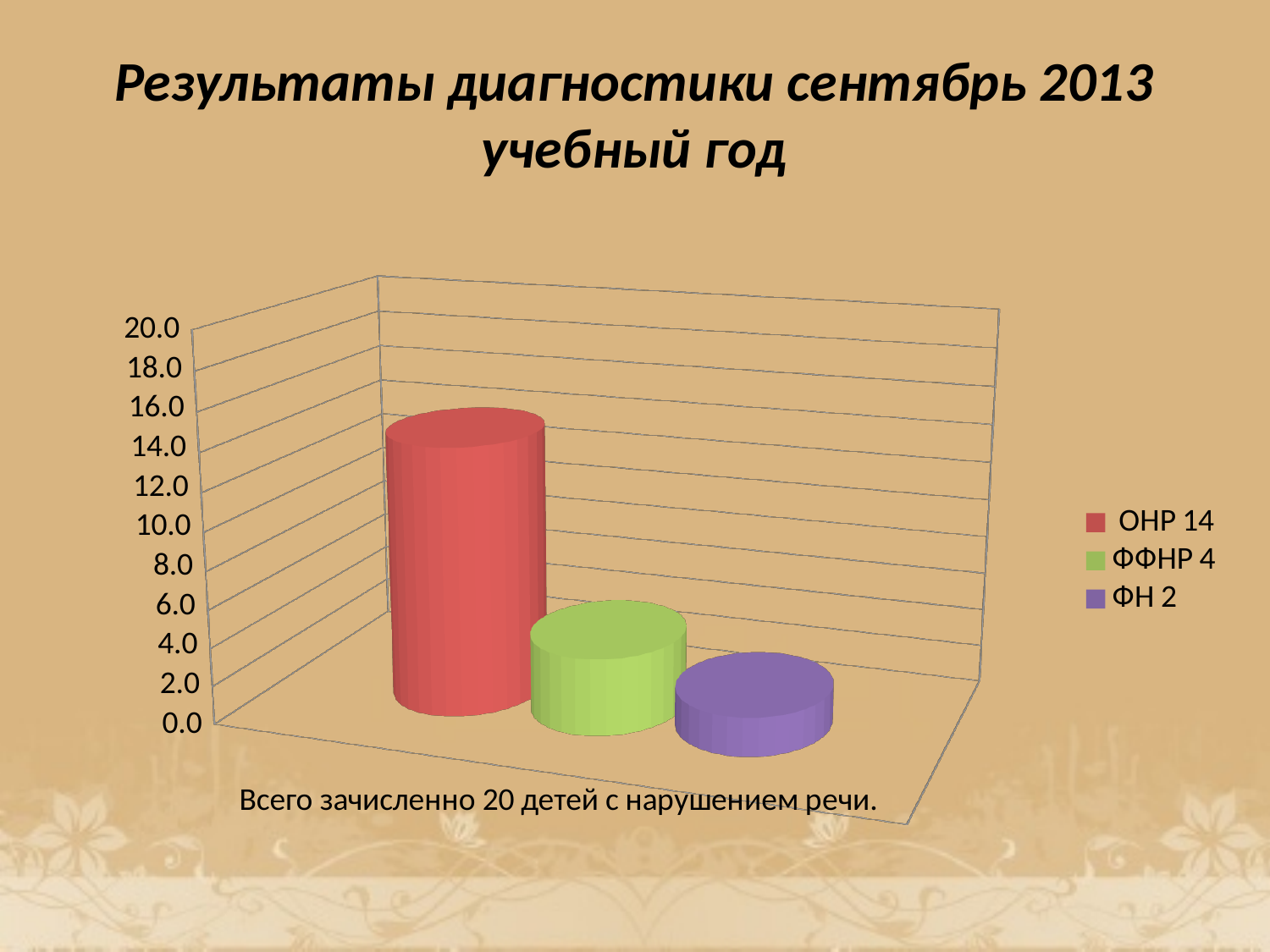
What is the difference between the numbers given for ОНР and ФФНР in the legend? 10 According to the legend, what number is given for ОНР? 14 Which legend entry has the shortest bar? ФН 2 How many entries does the chart legend list? 3 According to the legend, what number is given for ФН? 2 What kind of chart is shown on the slide? bar chart How many bars are plotted in the chart? 3 According to the legend, what number is given for ФФНР? 4 Which is larger, the bar for ФФНР or the bar for ФН? ФФНР Which legend entry has the tallest bar? ОНР 14 Is the value of the ОНР bar greater or less than 10.0? greater What colour is the bar for ОНР? red